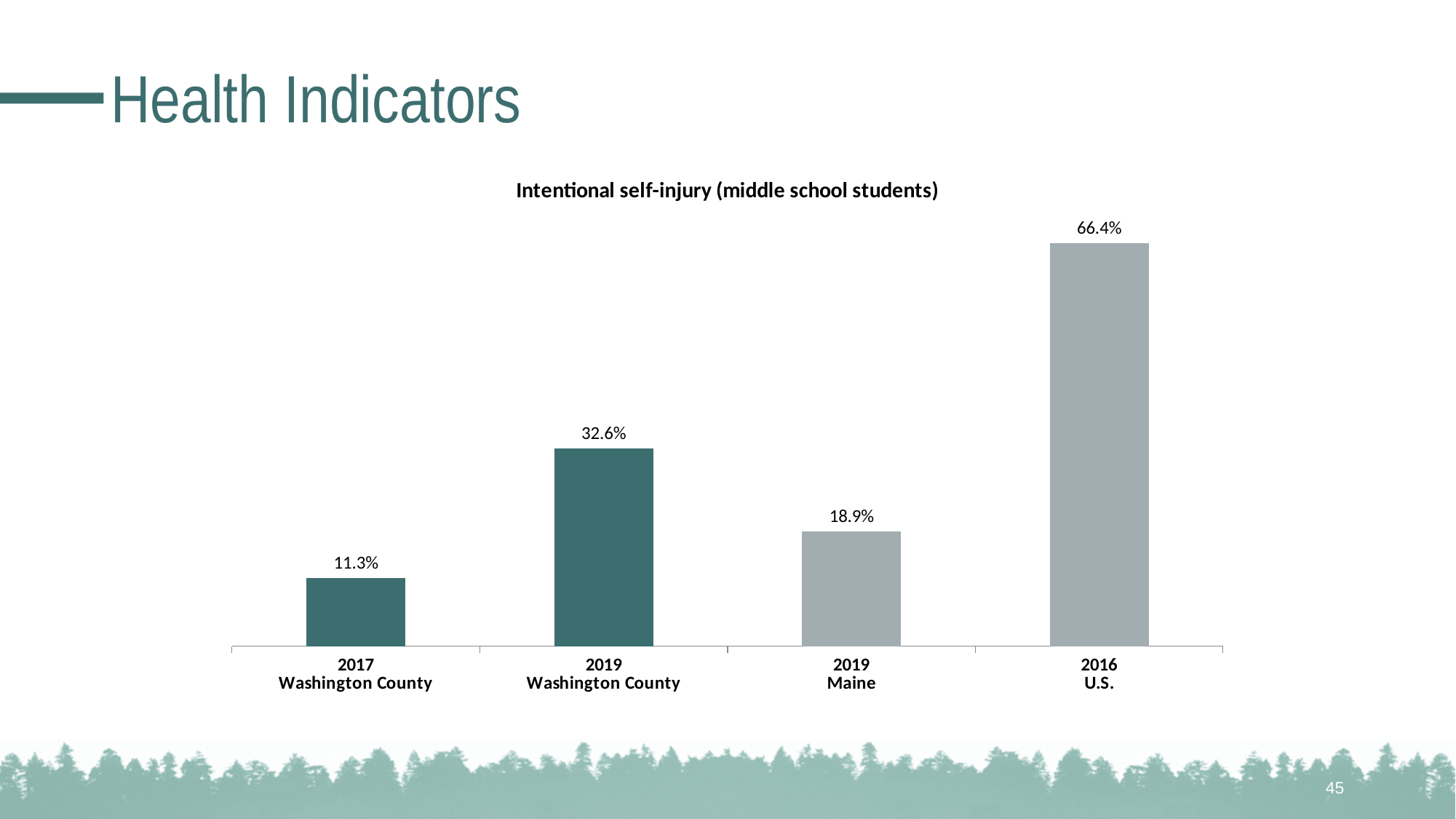
Which category has the lowest value? 2017 Washington County What is the title of the chart? Intentional self-injury (middle school students) What is the value for 2017 Washington County? 11.3% Which is larger, the value for 2019 Washington County or the value for 2019 Maine? 2019 Washington County What is the value for 2019 Washington County? 32.6% Which category has the highest value? 2016 U.S. What is the value for 2019 Maine? 18.9% How many bars are shown in the chart? 4 What is the difference between the 2019 Washington County value and the 2017 Washington County value? 21.3% What is the value for 2016 U.S.? 66.4% What is the difference between the 2016 U.S. value and the 2019 Maine value? 47.5% What kind of chart is shown on the slide? Bar chart